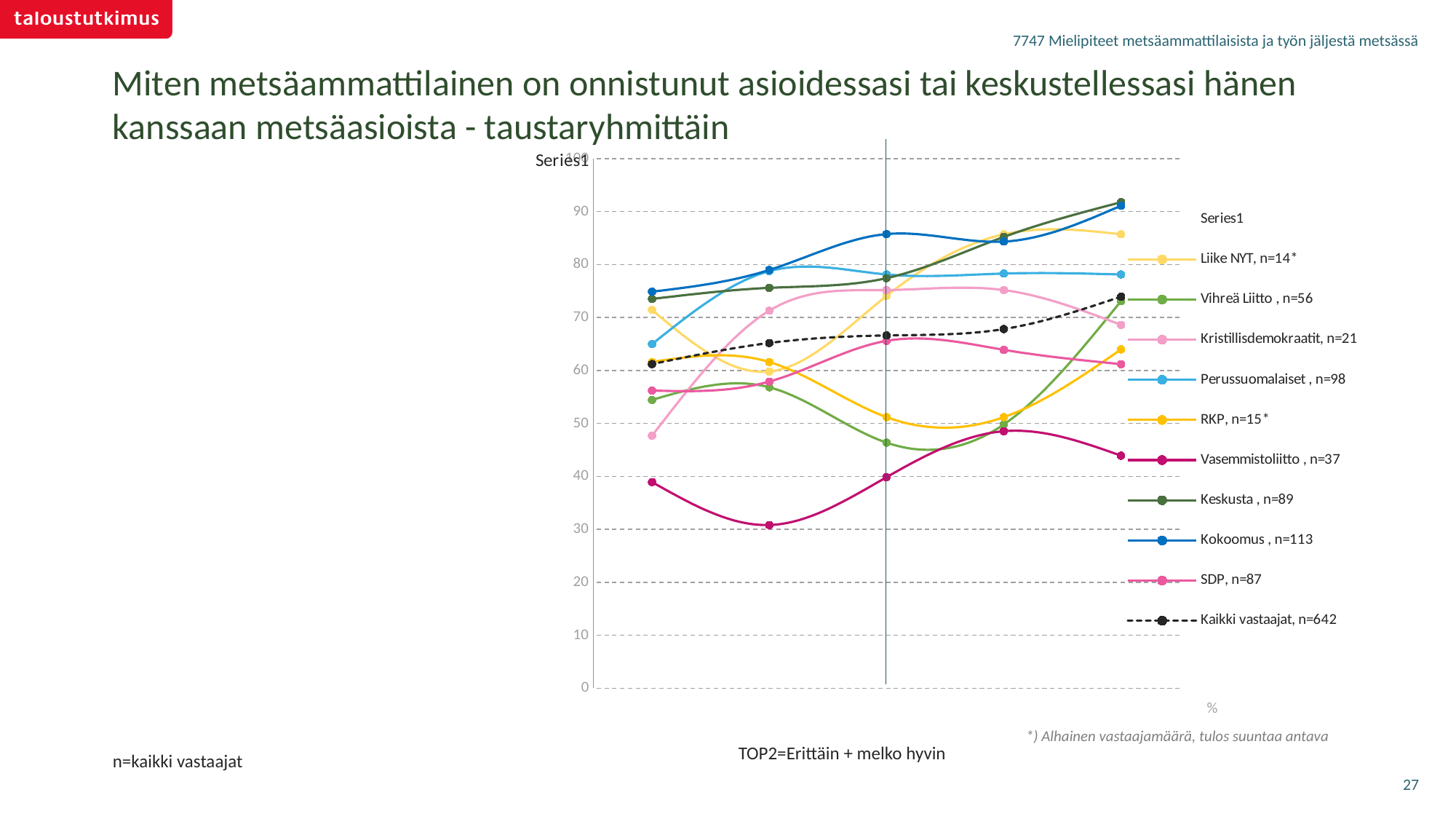
Which series has the lowest value at the first (leftmost) data point? Vasemmistoliitto, n=37 Is the value for Vasemmistoliitto at the second data point greater or less than 40? less Is the value for Kokoomus at the last (rightmost) data point greater or less than 80? greater How many data points does each line in the chart have? 5 What kind of chart is shown on the slide? line chart Which series has the lowest value at the second data point from the left? Vasemmistoliitto, n=37 Is the value for Liike NYT at the last (rightmost) data point greater or less than 80? greater Does the dashed 'Kaikki vastaajat' line rise or fall from left to right? rise Which legend entry has the largest number of respondents (n)? Kaikki vastaajat, n=642 At the last (rightmost) data point, which is larger: the value for Kokoomus or the value for SDP? Kokoomus Which series is drawn with a dashed black line? Kaikki vastaajat, n=642 How many series (background groups) does the legend list below the 'Series1' heading? 10